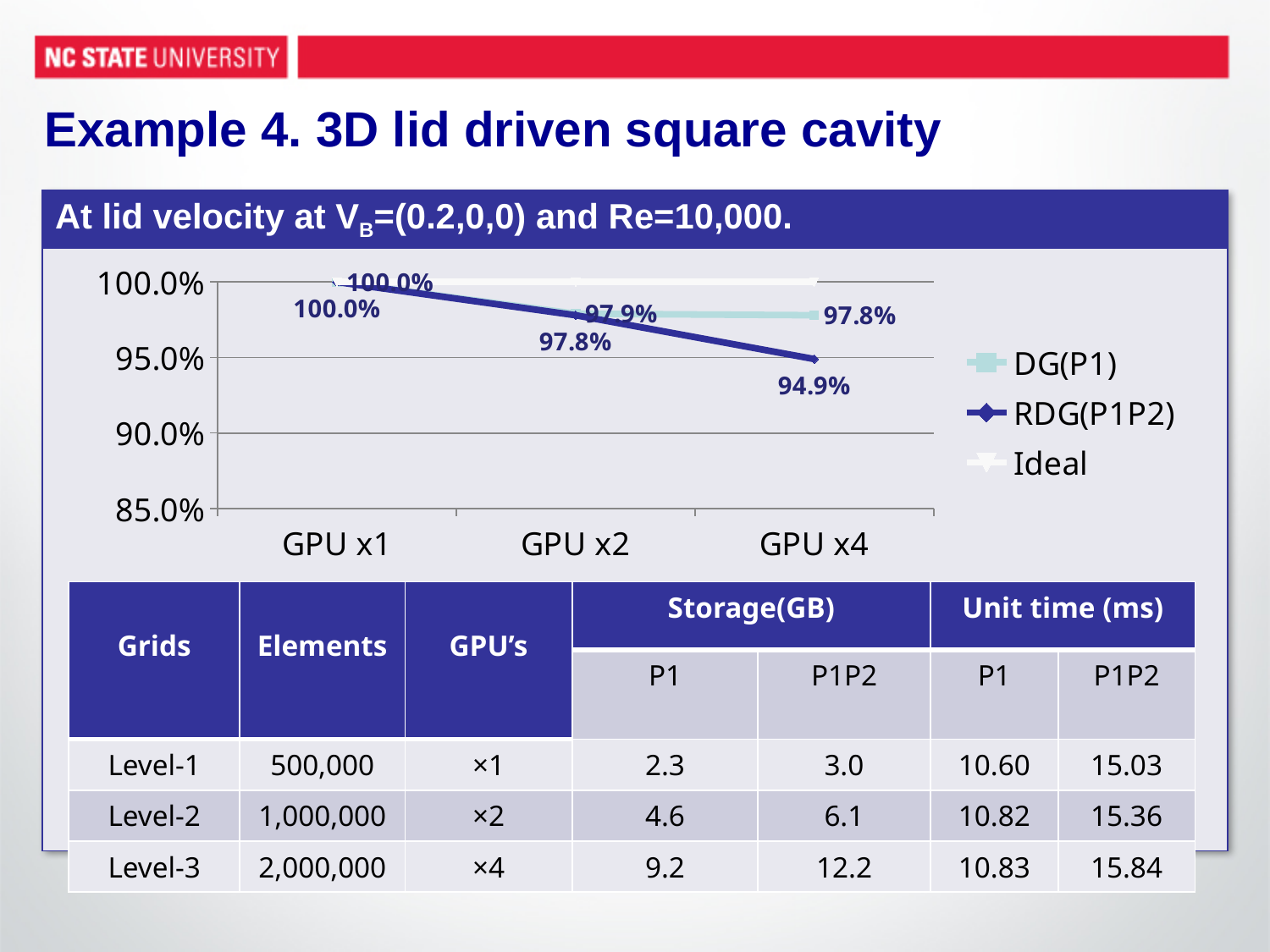
Does the RDG(P1P2) series rise or fall from GPU x1 to GPU x4? fall Is the value for RDG(P1P2) at GPU x4 greater or less than 95.0%? less What is the value for RDG(P1P2) at GPU x1? 100.0% What is the value for RDG(P1P2) at GPU x4? 94.9% At which GPU configuration is the RDG(P1P2) value lowest? GPU x4 What is the value for DG(P1) at GPU x4? 97.8% What kind of chart is shown on the slide? line chart What are the three series named in the chart legend? DG(P1), RDG(P1P2), Ideal How many GPU configurations are plotted along the x axis of the chart? 3 At GPU x4, which series has the higher value, DG(P1) or RDG(P1P2)? DG(P1) What is the difference between the DG(P1) and RDG(P1P2) values at GPU x4? 2.9% How many series does the chart legend list? 3